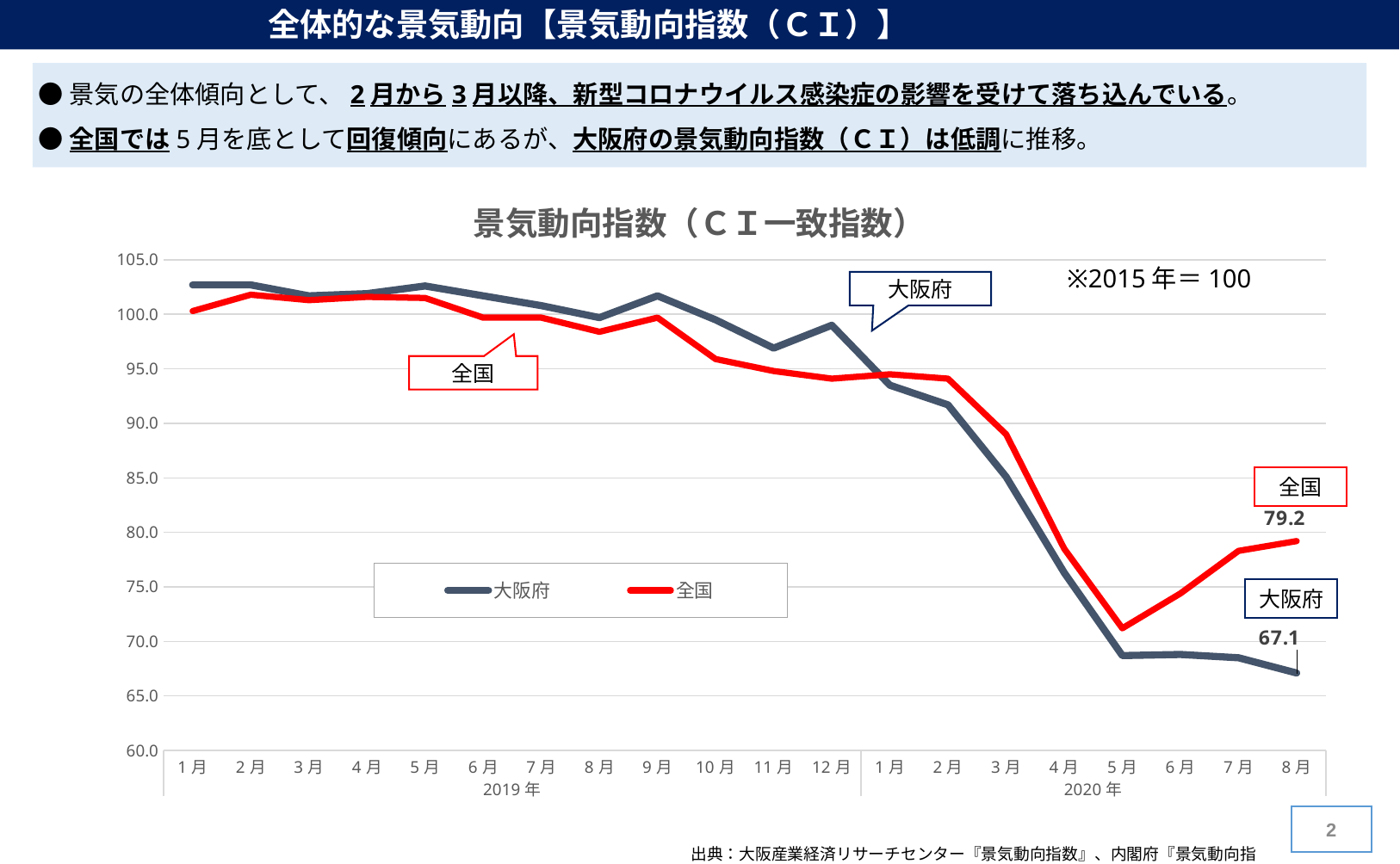
Is the value for 大阪府 in 2020年5月 greater or less than 70? less Is the value for 全国 in 2019年10月 greater or less than 100? less What kind of chart is shown on the slide? line chart In 2020年8月, which series has the higher value, 全国 or 大阪府? 全国 In which month does the 全国 series reach its lowest value? 2020年5月 What is the value for 大阪府 in 2020年8月? 67.1 How many months are plotted along the x axis? 20 What is the title of the chart? 景気動向指数（ＣＩ一致指数） Is the value for 大阪府 in 2019年1月 greater or less than 100? greater What is the difference between the 全国 and 大阪府 values in 2020年8月? 12.1 How many series does the legend list? 2 What is the value for 全国 in 2020年8月? 79.2